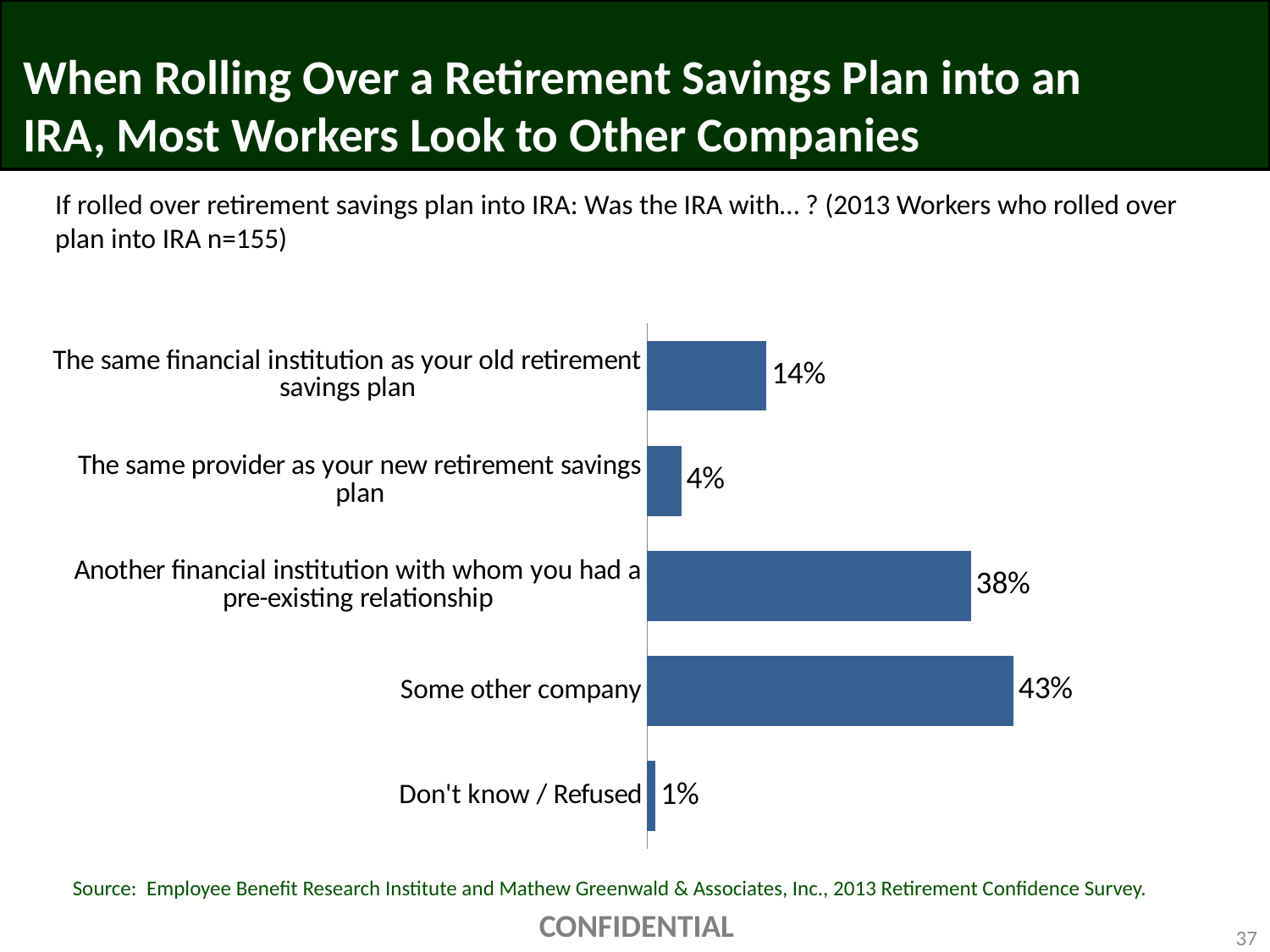
What is the difference in percentage points between 'Some other company' and 'Another financial institution with whom you had a pre-existing relationship'? 5 percentage points What percentage of workers answered 'Don't know / Refused'? 1% How many categories are shown in the chart? 5 Which category has the lowest percentage? Don't know / Refused Which category has the highest percentage? Some other company What percentage of workers rolled their plan into an IRA with the same provider as their new retirement savings plan? 4% What percentage of workers rolled their plan into an IRA with some other company? 43% What type of chart is shown on the slide? Bar chart What is the difference in percentage points between 'Another financial institution with whom you had a pre-existing relationship' and 'The same financial institution as your old retirement savings plan'? 24 percentage points Which is larger: the percentage for 'The same financial institution as your old retirement savings plan' or for 'The same provider as your new retirement savings plan'? The same financial institution as your old retirement savings plan What is the sample size (n) of workers who rolled over a plan into an IRA, as stated on the slide? 155 What percentage of workers rolled their plan into an IRA with the same financial institution as their old retirement savings plan? 14%